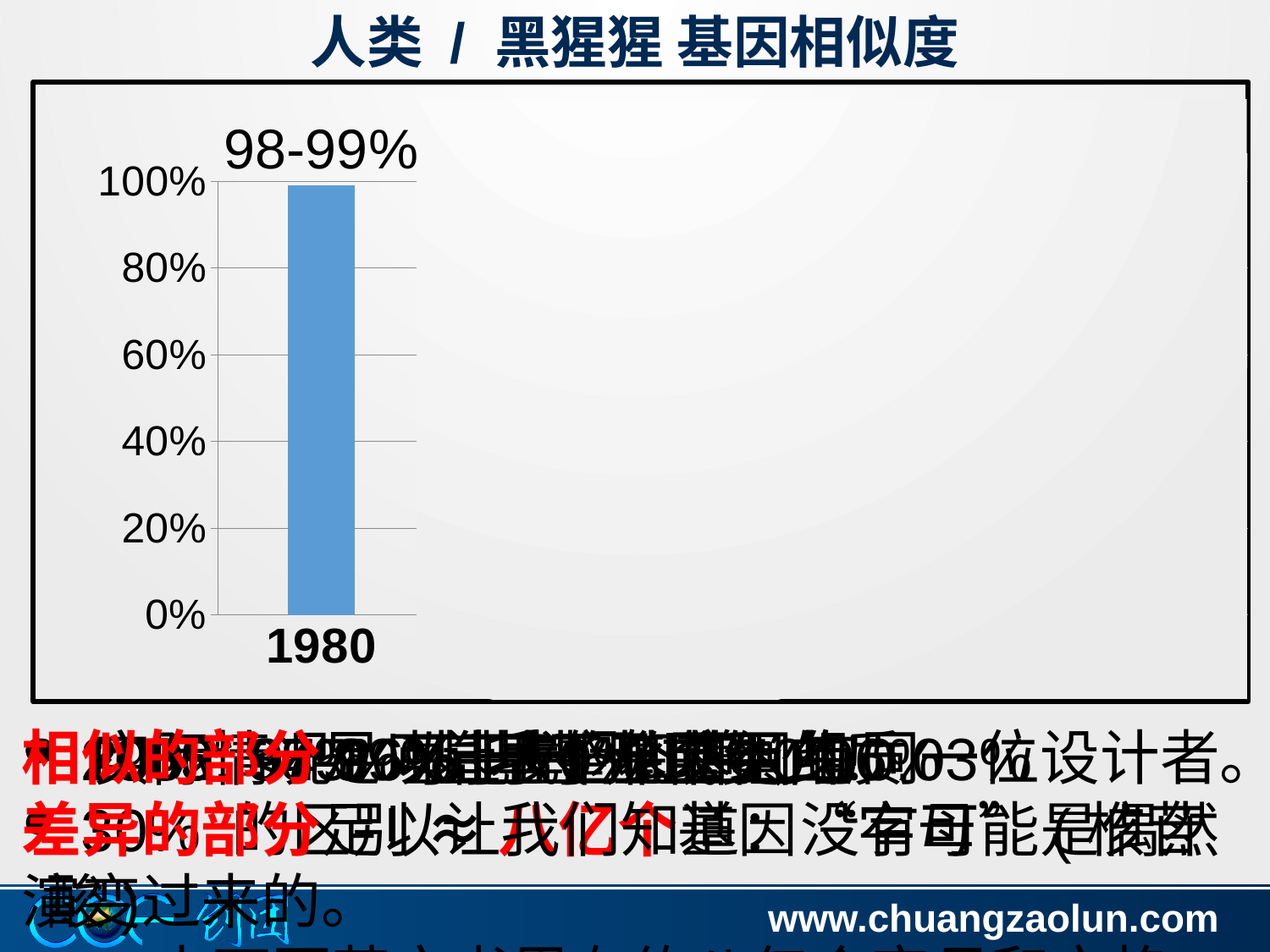
What kind of chart is shown on the slide? bar chart What value is labelled on the bar for 1980? 98-99% Is the value for 1980 greater or less than 60%? greater How many bars are plotted in the chart? 1 What is the title of the chart? 人类 / 黑猩猩 基因相似度 Which category label appears on the horizontal axis? 1980 What is the highest tick value shown on the vertical axis? 100% Is the value for 1980 greater or less than 80%? greater